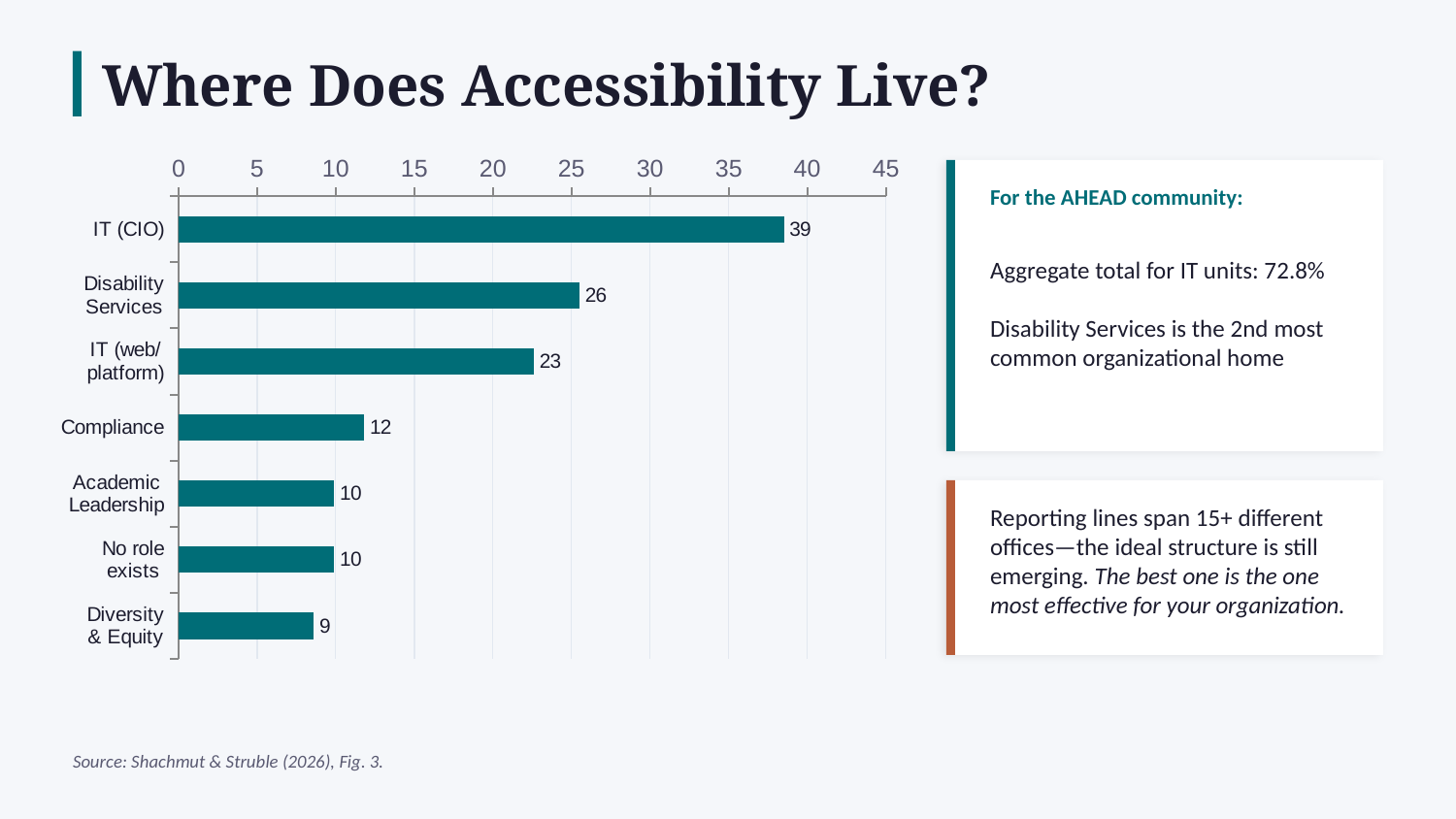
What is the highest tick value shown on the value axis? 45 Which category has the highest value? IT (CIO) How many categories are shown in the chart? 7 What is the value for IT (CIO)? 39 What is the value for Compliance? 12 What is the value for IT (web/platform)? 23 What is the difference between the values for IT (CIO) and Disability Services? 13 What is the value for Disability Services? 26 Which is larger, the value for Compliance or the value for IT (web/platform)? IT (web/platform) What is the value for Diversity & Equity? 9 What kind of chart is shown on the slide? Bar chart Which category has the lowest value? Diversity & Equity